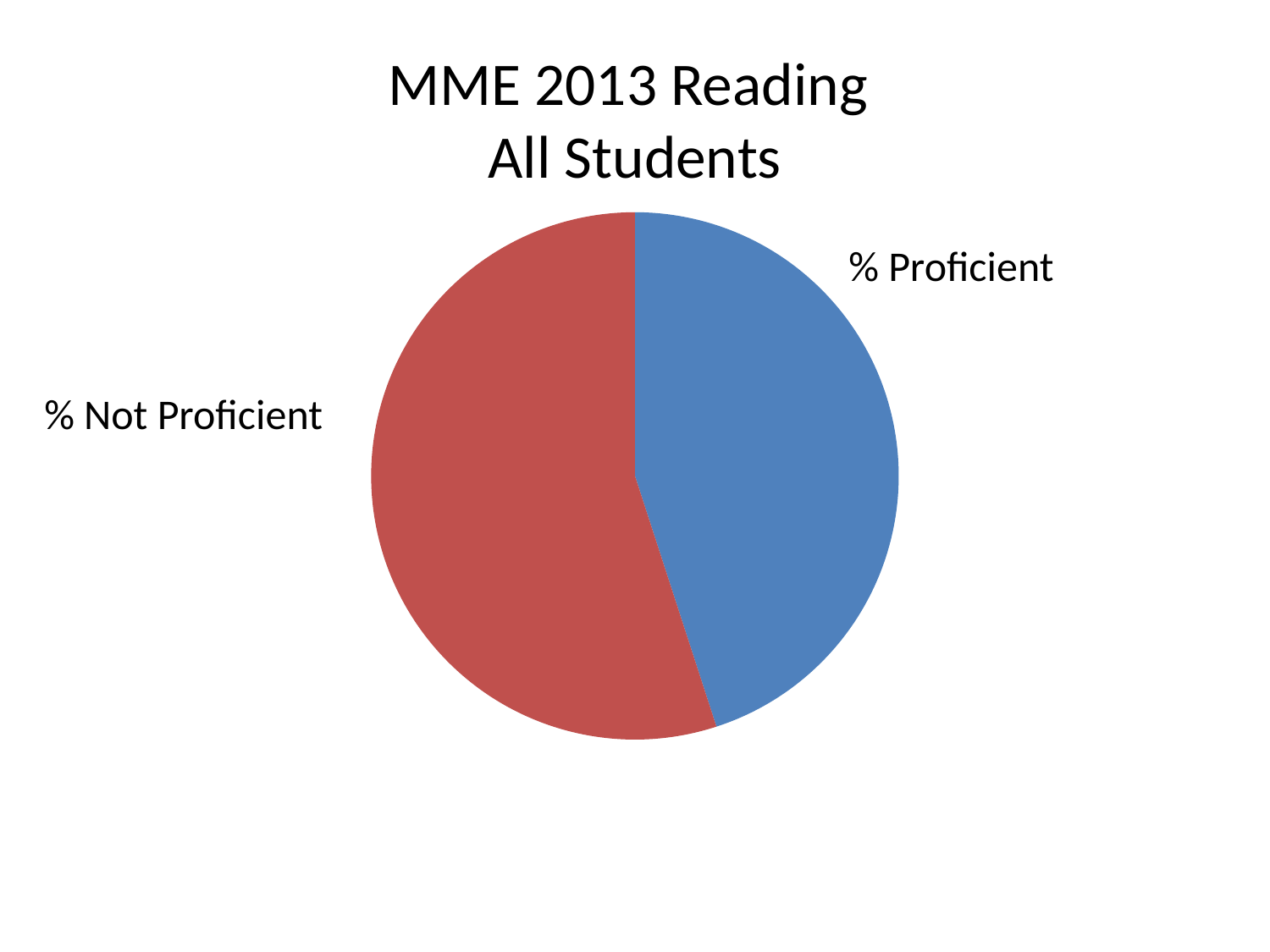
What is the title of the chart? MME 2013 Reading All Students What kind of chart is shown on the slide? pie chart How many slices does the pie chart have? 2 Which slice of the pie chart is the smallest? % Proficient Which slice of the pie chart is the largest? % Not Proficient Which is larger, the % Proficient slice or the % Not Proficient slice? % Not Proficient What colour is the % Proficient slice? blue